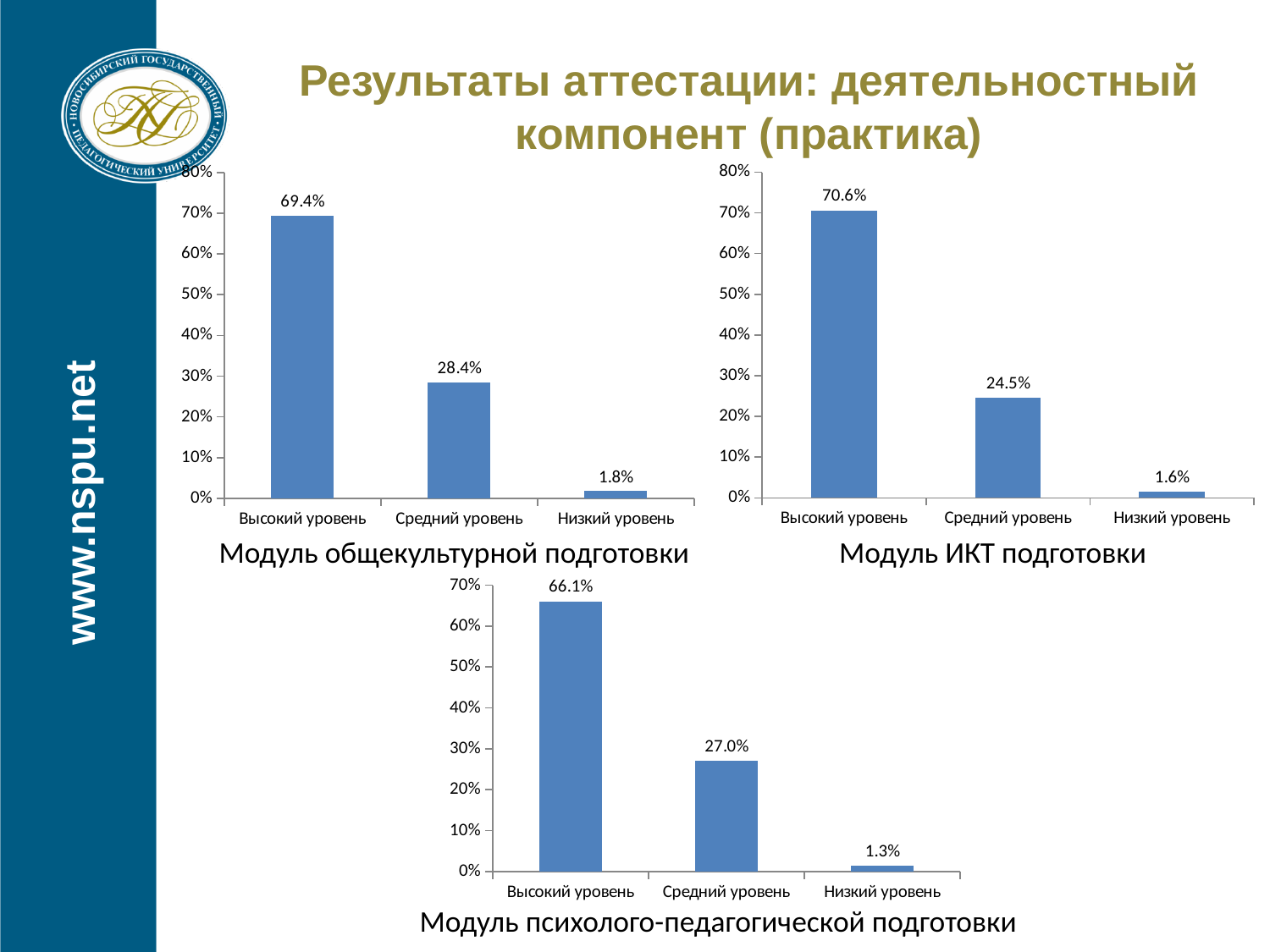
In the chart 'Модуль общекультурной подготовки', is the value for Средний уровень greater or less than 30%? less In the chart 'Модуль общекультурной подготовки', which category has the lowest value? Низкий уровень In the chart 'Модуль общекультурной подготовки', what is the value for Высокий уровень? 69.4% In the chart 'Модуль общекультурной подготовки', do the values rise or fall from left to right? fall How many categories are shown in the chart 'Модуль психолого-педагогической подготовки'? 3 What kind of chart is 'Модуль ИКТ подготовки'? bar chart In the chart 'Модуль ИКТ подготовки', what is the value for Средний уровень? 24.5% In the chart 'Модуль психолого-педагогической подготовки', what is the difference between Высокий уровень and Средний уровень? 39.1% In the chart 'Модуль ИКТ подготовки', what is the difference between Высокий уровень and Низкий уровень? 69.0% Which is larger: Высокий уровень in 'Модуль общекультурной подготовки' or Высокий уровень in 'Модуль ИКТ подготовки'? Модуль ИКТ подготовки In the chart 'Модуль ИКТ подготовки', which category has the highest value? Высокий уровень In the chart 'Модуль психолого-педагогической подготовки', what is the value for Низкий уровень? 1.3%